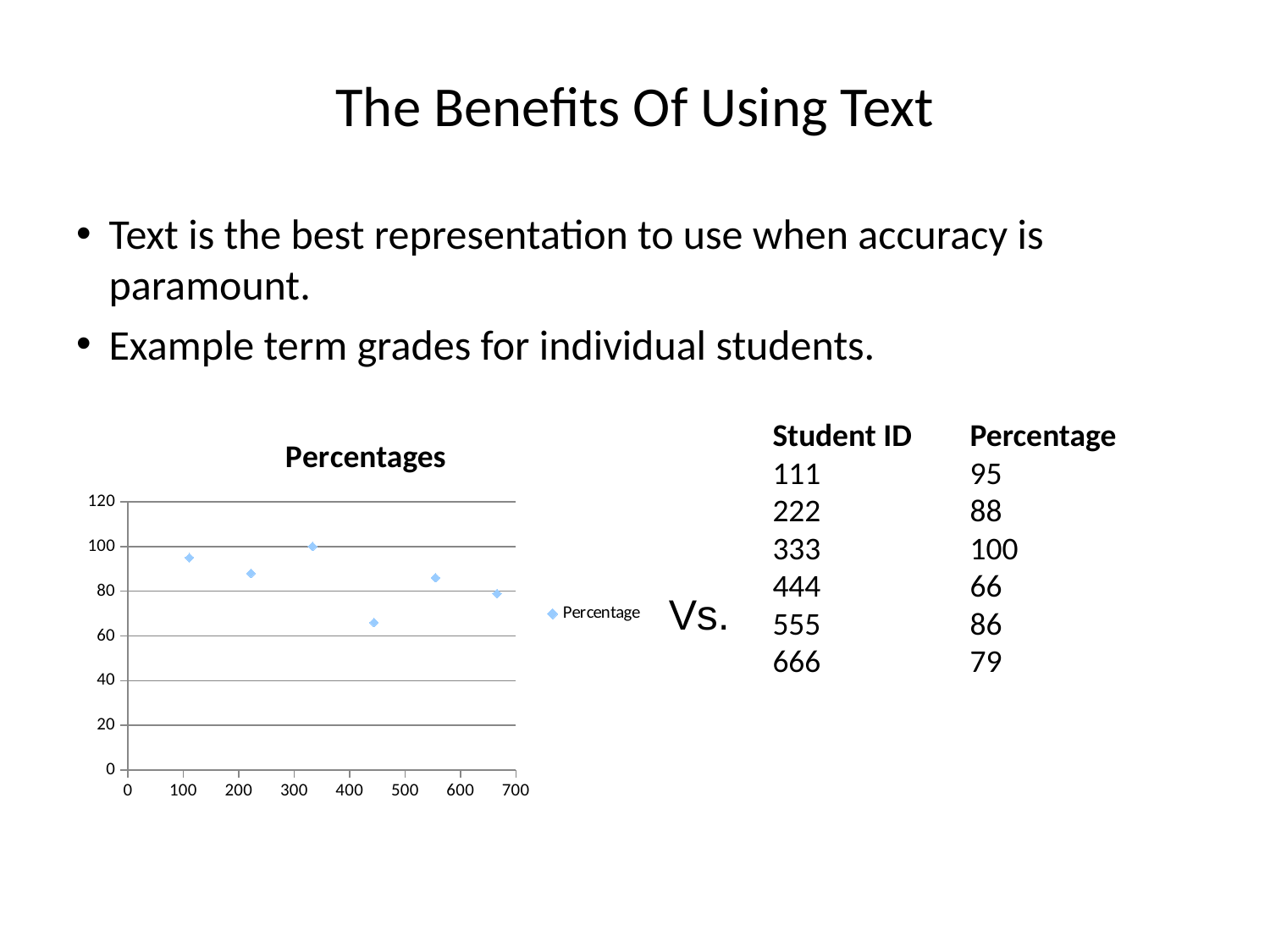
Is the value for the point at x = 222 greater or less than 80? greater Which is larger, the value at x = 333 or the value at x = 444? x = 333 What is the title of the chart? Percentages Is the value for the point at x = 444 greater or less than 80? less What is the plotted value for the point at x = 333? 100 Which x value has the highest plotted point? 333 What is the name of the series shown in the chart legend? Percentage What kind of chart is shown on the slide? scatter chart How many series does the chart legend list? 1 Is the value for the point at x = 111 greater or less than 80? greater How many data points are plotted in the chart? 6 Which x value has the lowest plotted point? 444